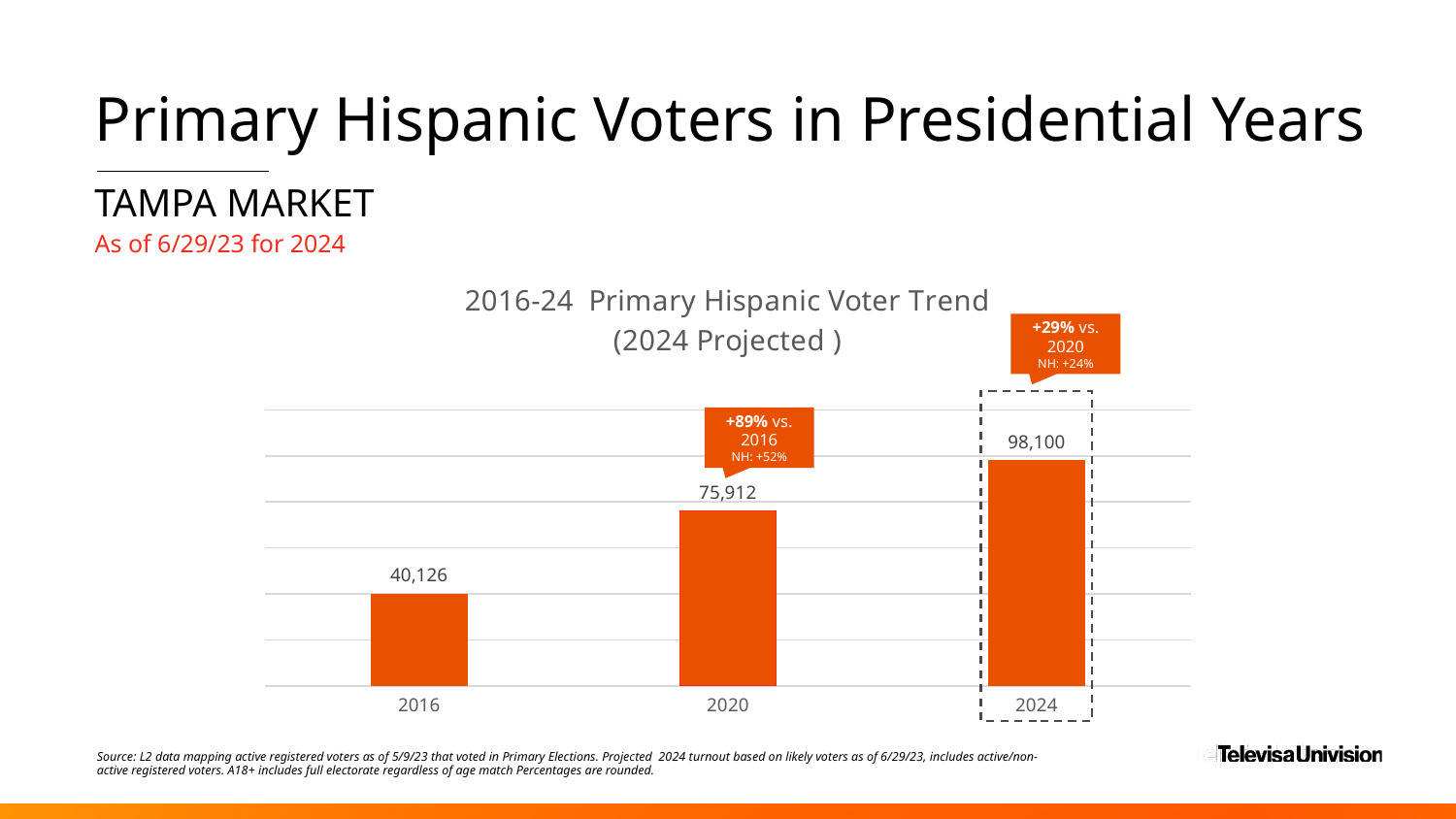
What is the difference between the 2024 and 2020 values? 22,188 What is the value for 2020 in the chart? 75,912 What is the value for 2016 in the chart? 40,126 What kind of chart is shown on the slide? Bar chart Which year has the highest value in the chart? 2024 What is the title of the chart? 2016-24 Primary Hispanic Voter Trend (2024 Projected ) What is the projected value for 2024 in the chart? 98,100 Which is larger, the value for 2016 or the value for 2020? 2020 What is the difference between the 2020 and 2016 values? 35,786 Which year has the lowest value in the chart? 2016 How many years are plotted in the chart? 3 Do the values rise or fall from 2016 to 2024? Rise